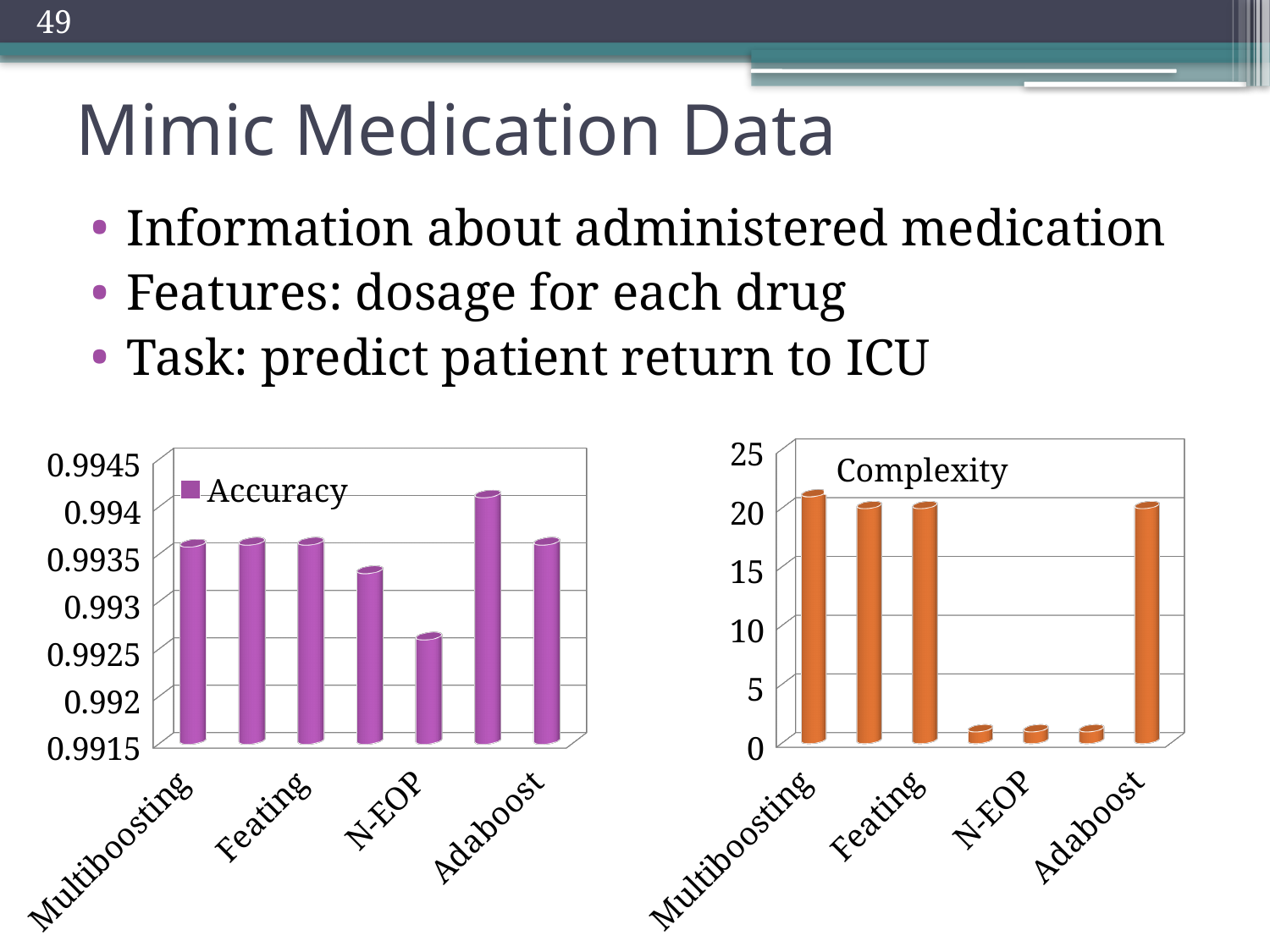
In the Complexity chart, which has the higher complexity, Adaboost or N-EOP? Adaboost In the left chart, is the accuracy value for N-EOP greater or less than 0.993? less How many bars are plotted in the Complexity chart on the right? 7 What kind of chart is the left chart on the slide? bar chart How many series does the legend of the left chart list? 1 In the left chart, which has the higher accuracy, Feating or N-EOP? Feating In the Complexity chart, is the value for N-EOP greater or less than 5? less What is the legend entry shown in the left chart? Accuracy What is the title of the right chart? Complexity In the left chart, is the accuracy value for Multiboosting greater or less than 0.993? greater In the left chart, which labeled category has the lowest accuracy? N-EOP